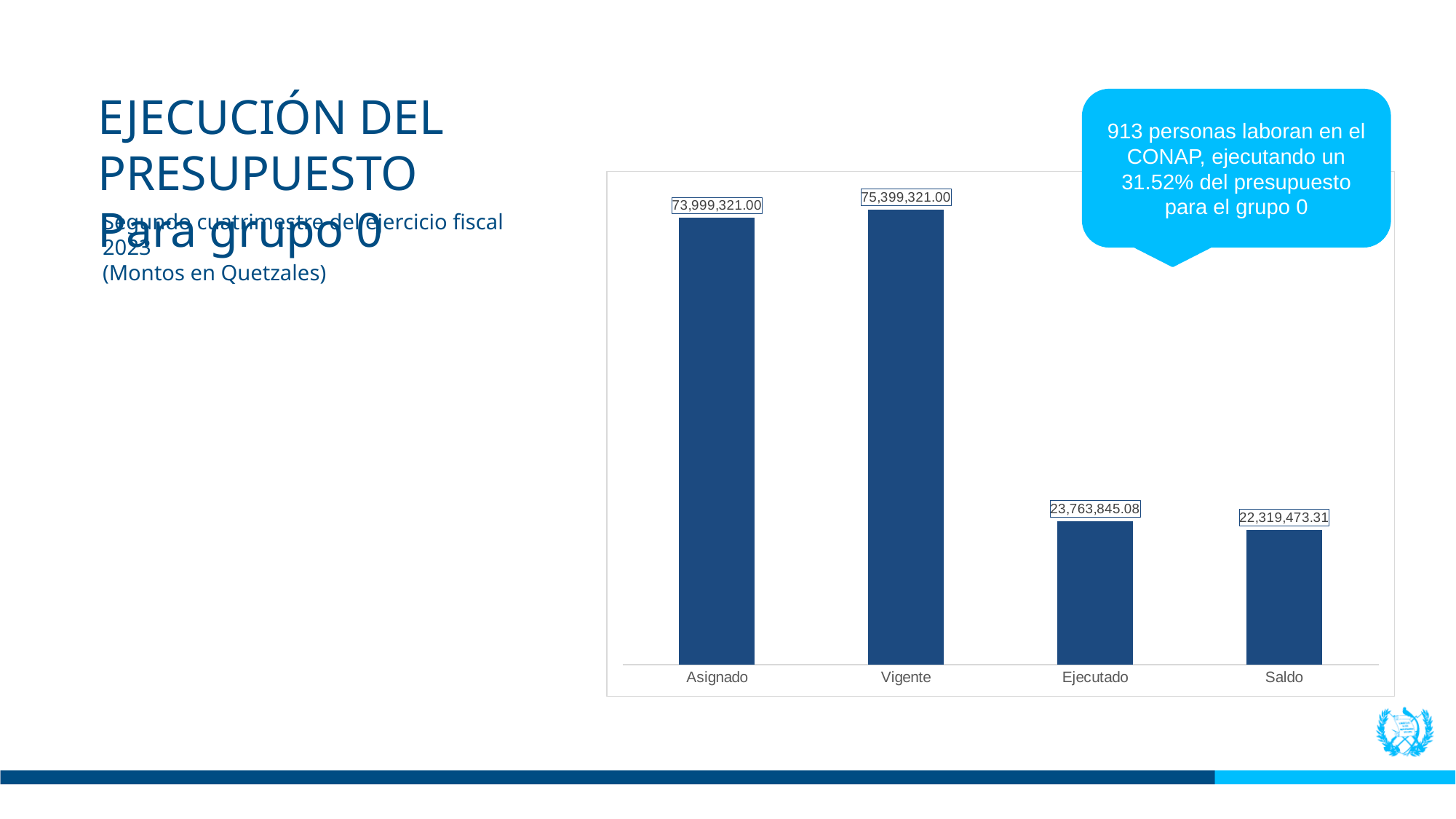
Do the values rise or fall from Vigente to Saldo along the x axis? Fall What is the difference between the Vigente and Asignado values? 1,400,000.00 What is the value of the Ejecutado bar? 23,763,845.08 Which is larger, the Asignado value or the Vigente value? Vigente What is the difference between the Ejecutado and Saldo values? 1,444,371.77 What is the value of the Saldo bar? 22,319,473.31 Which category has the lowest value? Saldo What kind of chart is shown on the slide? Bar chart How many categories are shown on the x axis? 4 What is the value of the Vigente bar? 75,399,321.00 Which category has the highest value? Vigente What is the value of the Asignado bar? 73,999,321.00